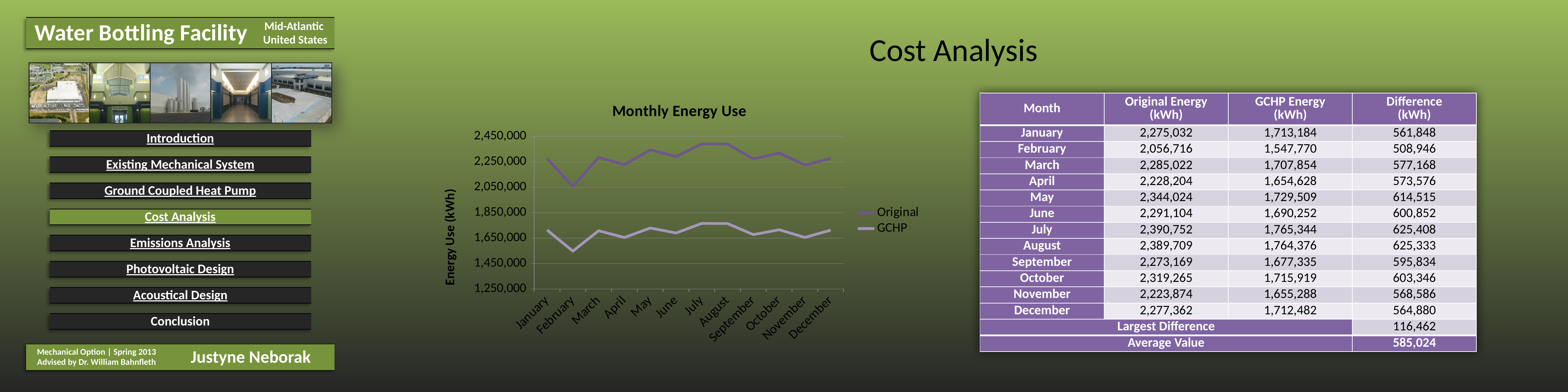
Is the Original value for July greater or less than 2,250,000? greater What is the label on the vertical axis of the chart? Energy Use (kWh) What kind of chart is shown on the slide? line chart What is the title of the chart? Monthly Energy Use How many series does the legend of the Monthly Energy Use chart list? 2 How many months are plotted along the x axis of the Monthly Energy Use chart? 12 Does the Original series rise or fall from January to February? fall In which month is the Original series at its lowest value? February Is the GCHP value for February greater or less than 1,650,000? less Which series has the higher value in July, Original or GCHP? Original In which month is the GCHP series at its lowest value? February Which is larger for the Original series, the value in March or the value in February? March